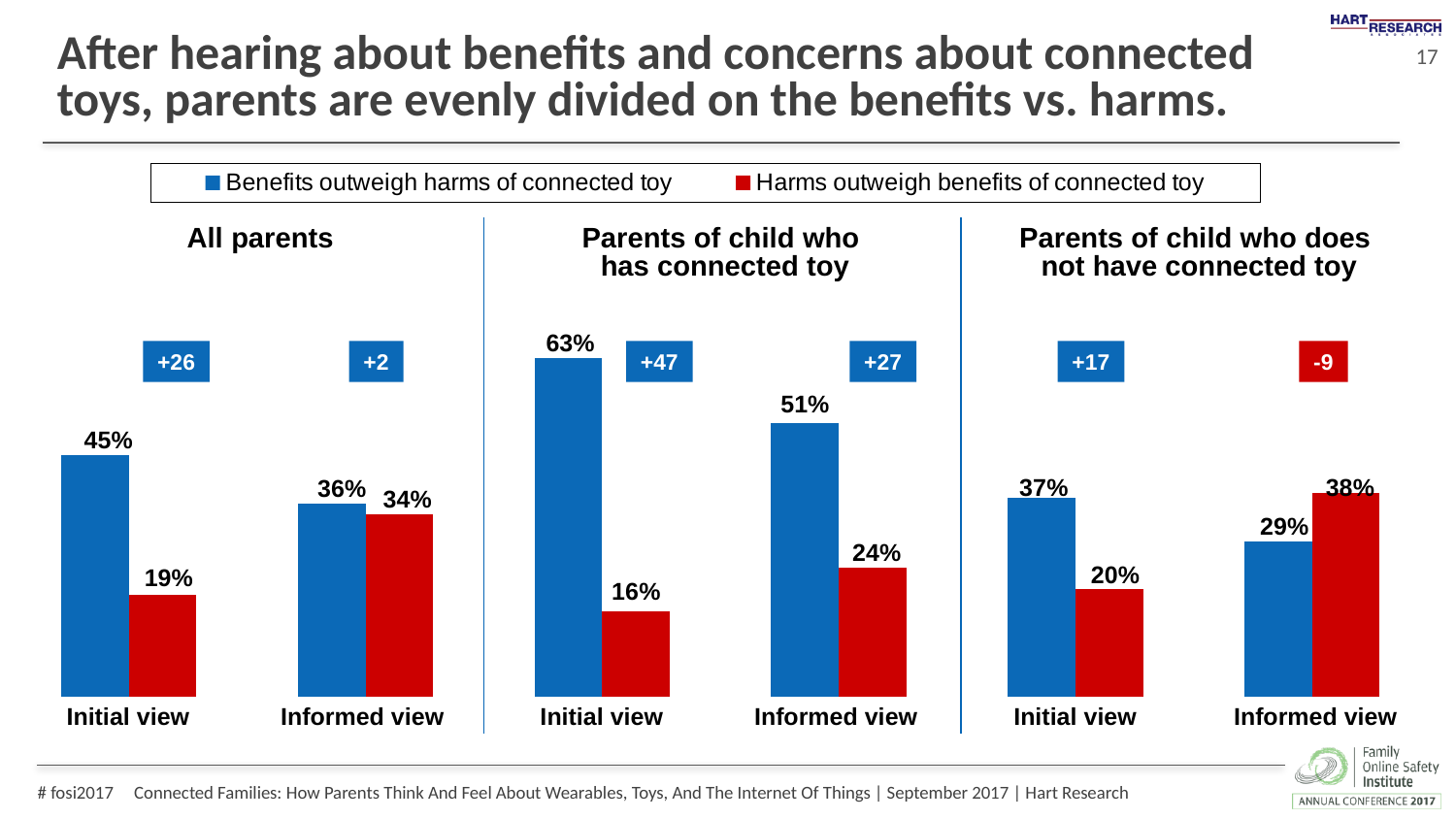
In the 'All parents' chart, what percentage say harms outweigh benefits in the informed view? 34% In the 'Parents of child who has connected toy' chart, what is the difference between benefits outweigh harms and harms outweigh benefits in the informed view? 27 percentage points In the 'All parents' chart, what percentage say benefits outweigh harms in the initial view? 45% In the 'All parents' chart, what is the difference between the benefits and harms percentages in the initial view? 26 percentage points What type of chart is used on this slide? Bar chart Across all three charts, which group and view has the highest percentage saying benefits outweigh harms? Parents of child who has connected toy, initial view (63%) In the 'Parents of child who has connected toy' chart, what percentage say benefits outweigh harms in the initial view? 63% In the 'Parents of child who does not have connected toy' chart, which is larger in the informed view: benefits outweigh harms or harms outweigh benefits? Harms outweigh benefits of connected toy Across all three charts, which group and view has the lowest percentage saying harms outweigh benefits? Parents of child who has connected toy, initial view (16%) In the 'Parents of child who does not have connected toy' chart, does the percentage saying benefits outweigh harms rise or fall from the initial view to the informed view? Fall How many series does the legend list? 2 In the 'Parents of child who does not have connected toy' chart, what percentage say harms outweigh benefits in the informed view? 38%